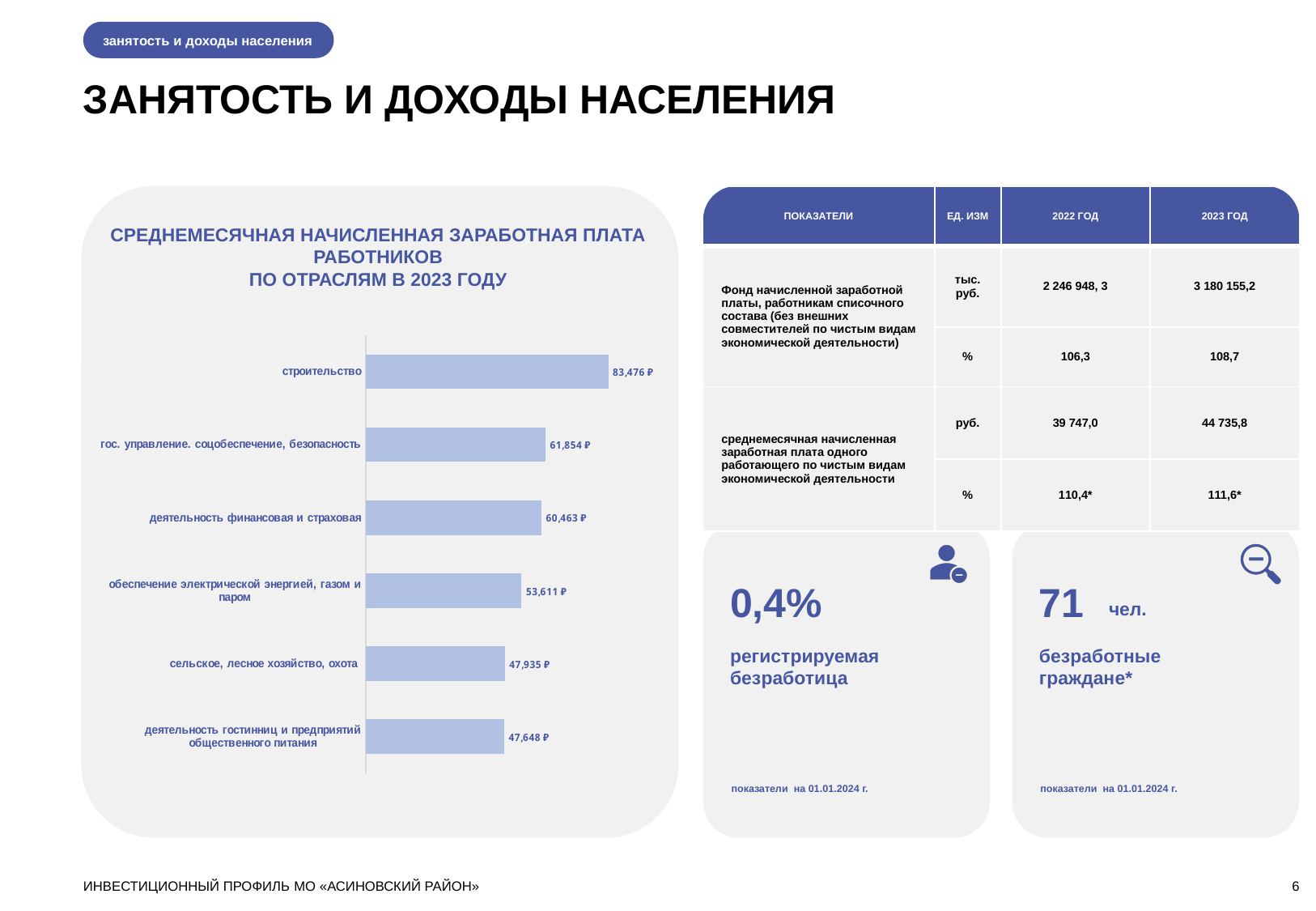
Which industry has the highest average monthly salary in the chart? строительство What type of chart is used to show average monthly salary by industry? bar chart Which is larger: the salary for гос. управление, соцобеспечение, безопасность or for обеспечение электрической энергией, газом и паром? гос. управление, соцобеспечение, безопасность What is the difference between the salary for строительство and for гос. управление, соцобеспечение, безопасность? 21,622 ₽ What value is shown for деятельность финансовая и страховая? 60,463 ₽ What is the value for сельское, лесное хозяйство, охота? 47,935 ₽ Which industry has the lowest average monthly salary in the chart? деятельность гостиниц и предприятий общественного питания What is the average monthly salary shown for строительство? 83,476 ₽ What is the title of the chart on the left of the slide? СРЕДНЕМЕСЯЧНАЯ НАЧИСЛЕННАЯ ЗАРАБОТНАЯ ПЛАТА РАБОТНИКОВ ПО ОТРАСЛЯМ В 2023 ГОДУ What value is shown for обеспечение электрической энергией, газом и паром? 53,611 ₽ What is the difference between the salary for сельское, лесное хозяйство, охота and for деятельность гостиниц и предприятий общественного питания? 287 ₽ How many industries are shown in the bar chart? 6